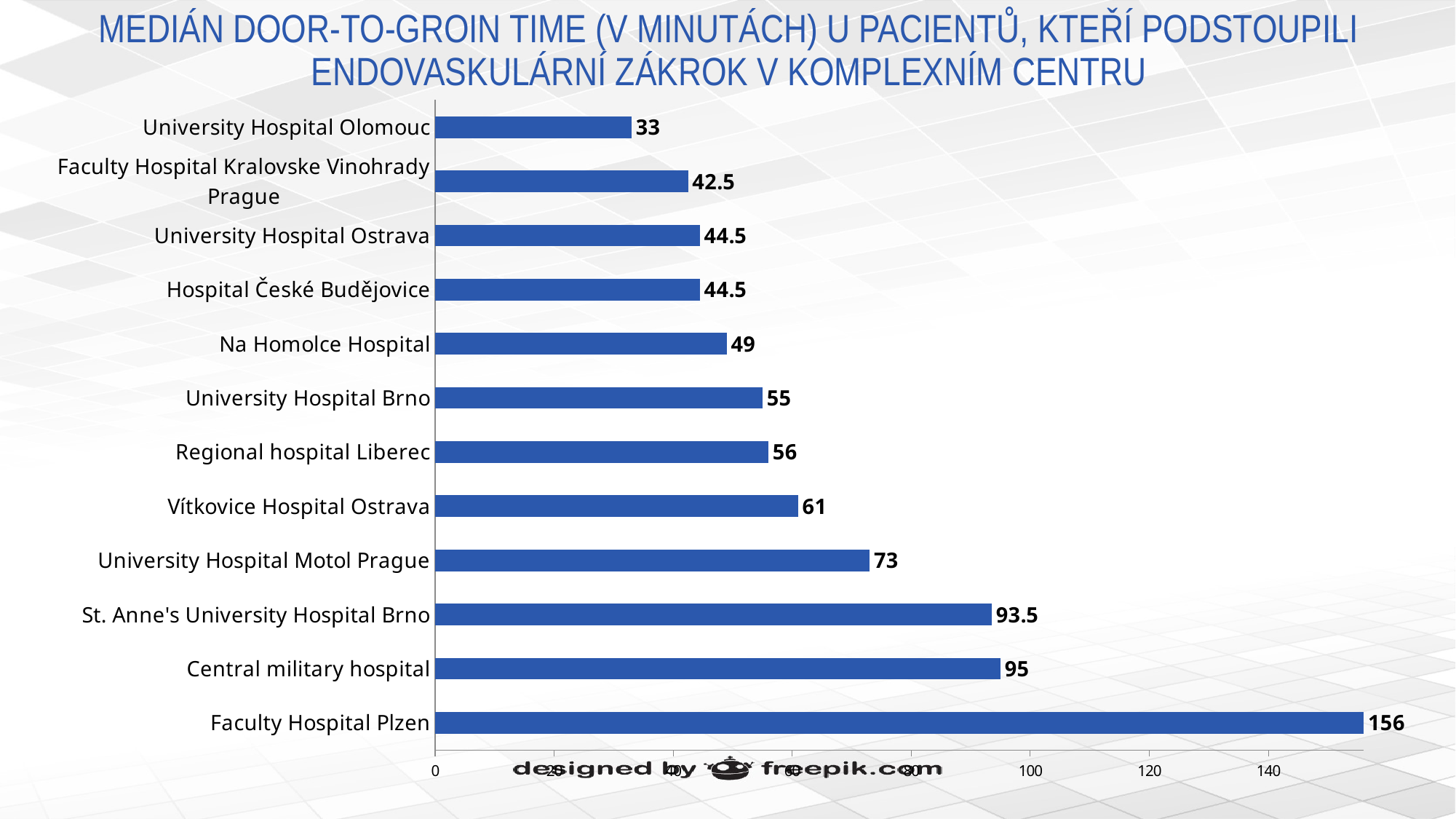
What is the difference between the values for Faculty Hospital Plzen and Central military hospital? 61 Which has a larger value, University Hospital Motol Prague or Vítkovice Hospital Ostrava? University Hospital Motol Prague What is the value shown for Faculty Hospital Plzen? 156 What kind of chart is shown on the slide? bar chart Which hospital has the highest median door-to-groin time? Faculty Hospital Plzen Which hospital has the lowest median door-to-groin time? University Hospital Olomouc What is the difference between the values for University Hospital Brno and Regional hospital Liberec? 1 What is the value shown for St. Anne's University Hospital Brno? 93.5 Is the value for Central military hospital greater or less than 100? less How many hospitals are shown in the chart? 12 What is the median door-to-groin time for University Hospital Olomouc? 33 What is the value shown for Na Homolce Hospital? 49